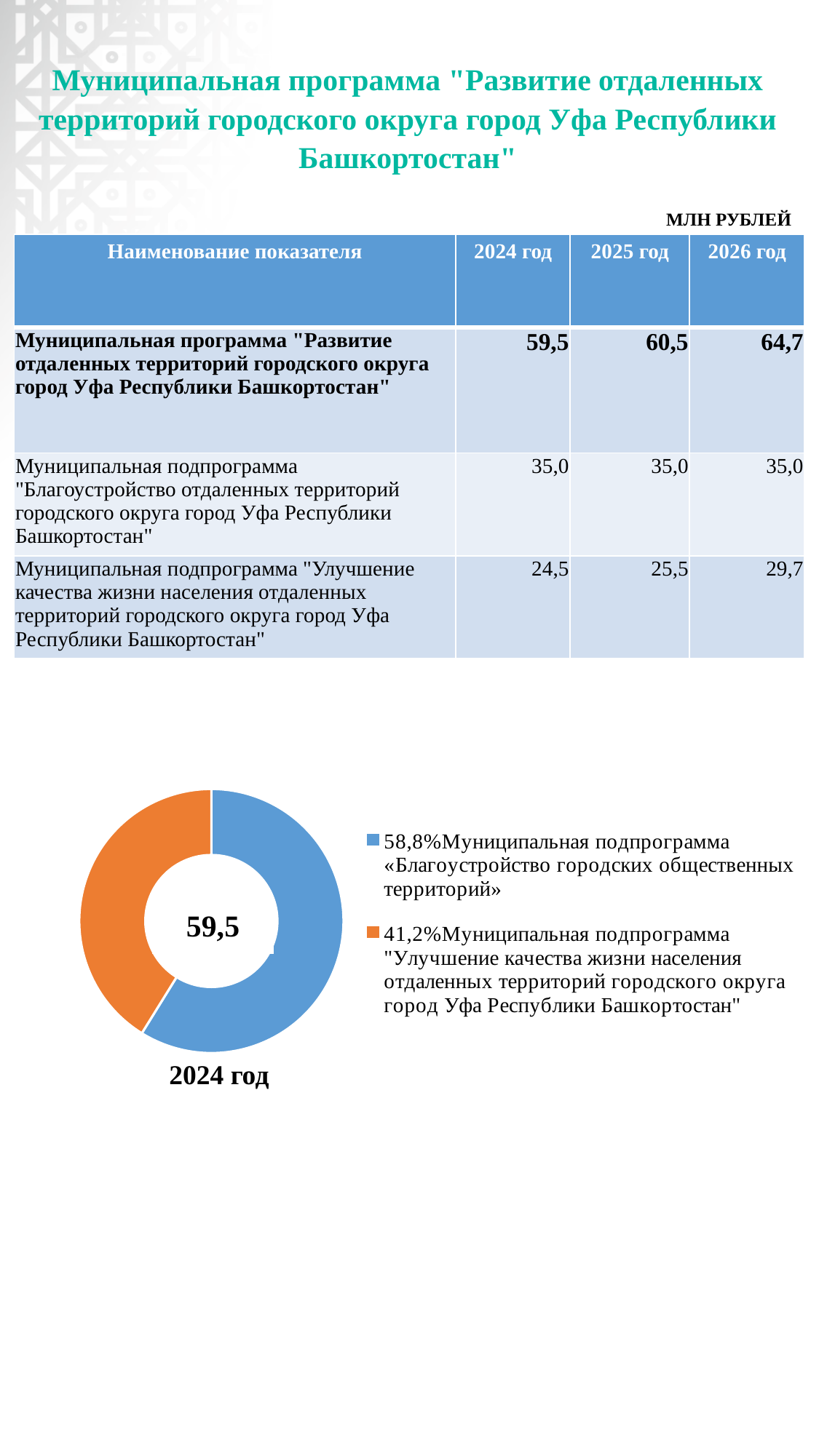
By how many percentage points does the share of «Благоустройство городских общественных территорий» exceed the share of "Улучшение качества жизни населения отдаленных территорий" in the doughnut chart? 17,6 What colour is the slice for the subprogram "Улучшение качества жизни населения отдаленных территорий" in the doughnut chart? orange In the doughnut chart, which is larger: the share for «Благоустройство городских общественных территорий» or the share for "Улучшение качества жизни населения отдаленных территорий"? «Благоустройство городских общественных территорий» What share of the doughnut chart is the subprogram «Благоустройство городских общественных территорий»? 58,8% Which slice of the doughnut chart is the largest? Муниципальная подпрограмма «Благоустройство городских общественных территорий» What value is printed in the centre of the doughnut chart? 59,5 What kind of chart is shown on the slide? doughnut (pie) chart What share of the doughnut chart is the subprogram "Улучшение качества жизни населения отдаленных территорий городского округа город Уфа Республики Башкортостан"? 41,2% How many slices does the doughnut chart have? 2 Which slice of the doughnut chart is the smallest? Муниципальная подпрограмма "Улучшение качества жизни населения отдаленных территорий городского округа город Уфа Республики Башкортостан" Which year is the doughnut chart labelled with? 2024 год How many entries does the legend of the doughnut chart list? 2